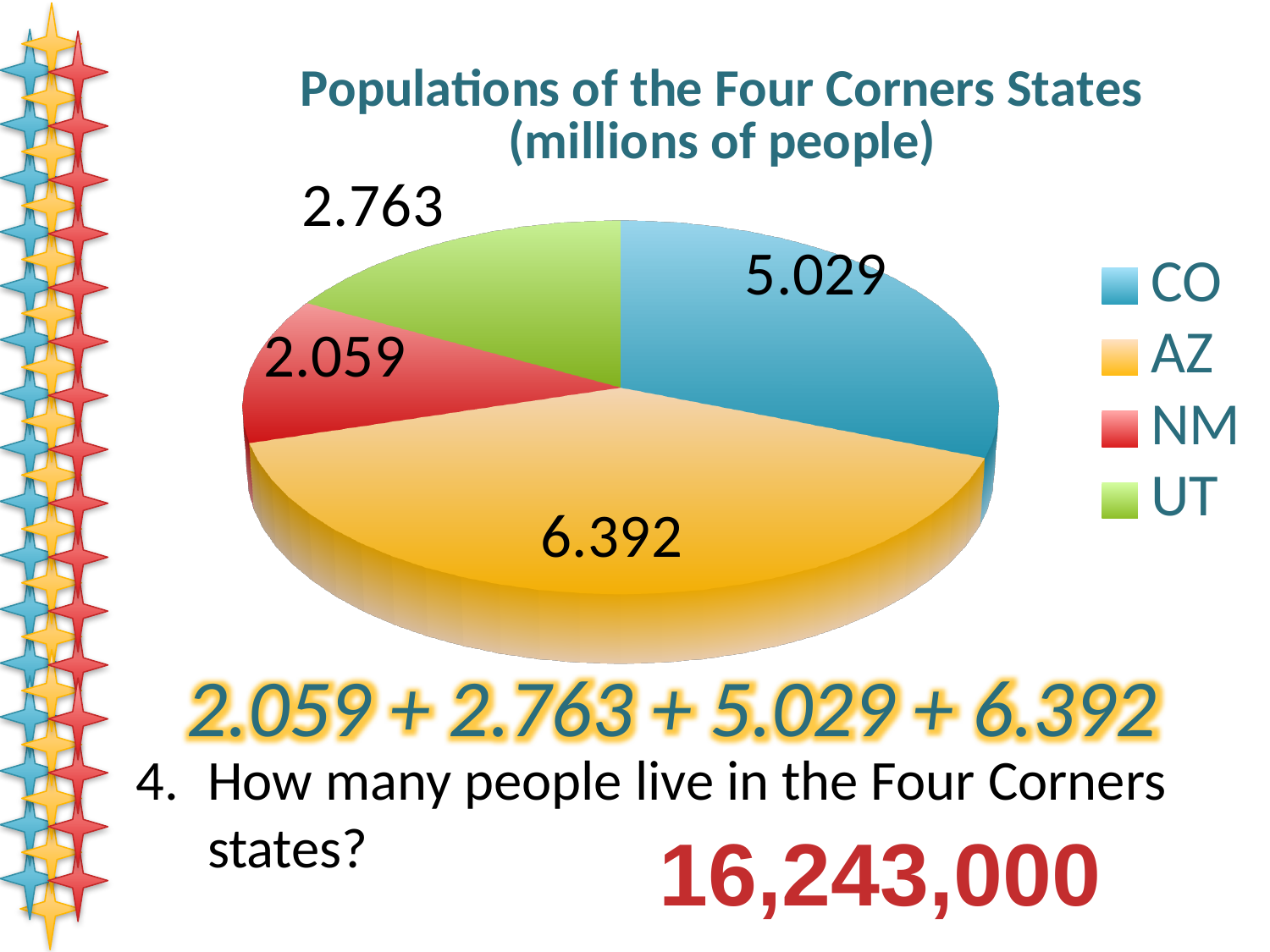
How many states are shown in the pie chart? 4 What is the population value shown for AZ in the pie chart? 6.392 What is the difference between the values for AZ and CO? 1.363 What is the population value shown for NM in the pie chart? 2.059 What is the population value shown for CO in the pie chart? 5.029 Which state has the smallest slice in the pie chart? NM What is the population value shown for UT in the pie chart? 2.763 Which state has the largest slice in the pie chart? AZ What is the difference between the values for UT and NM? 0.704 Which has a larger value, CO or UT? CO What kind of chart is shown on the slide? Pie chart What is the title of the chart? Populations of the Four Corners States (millions of people)